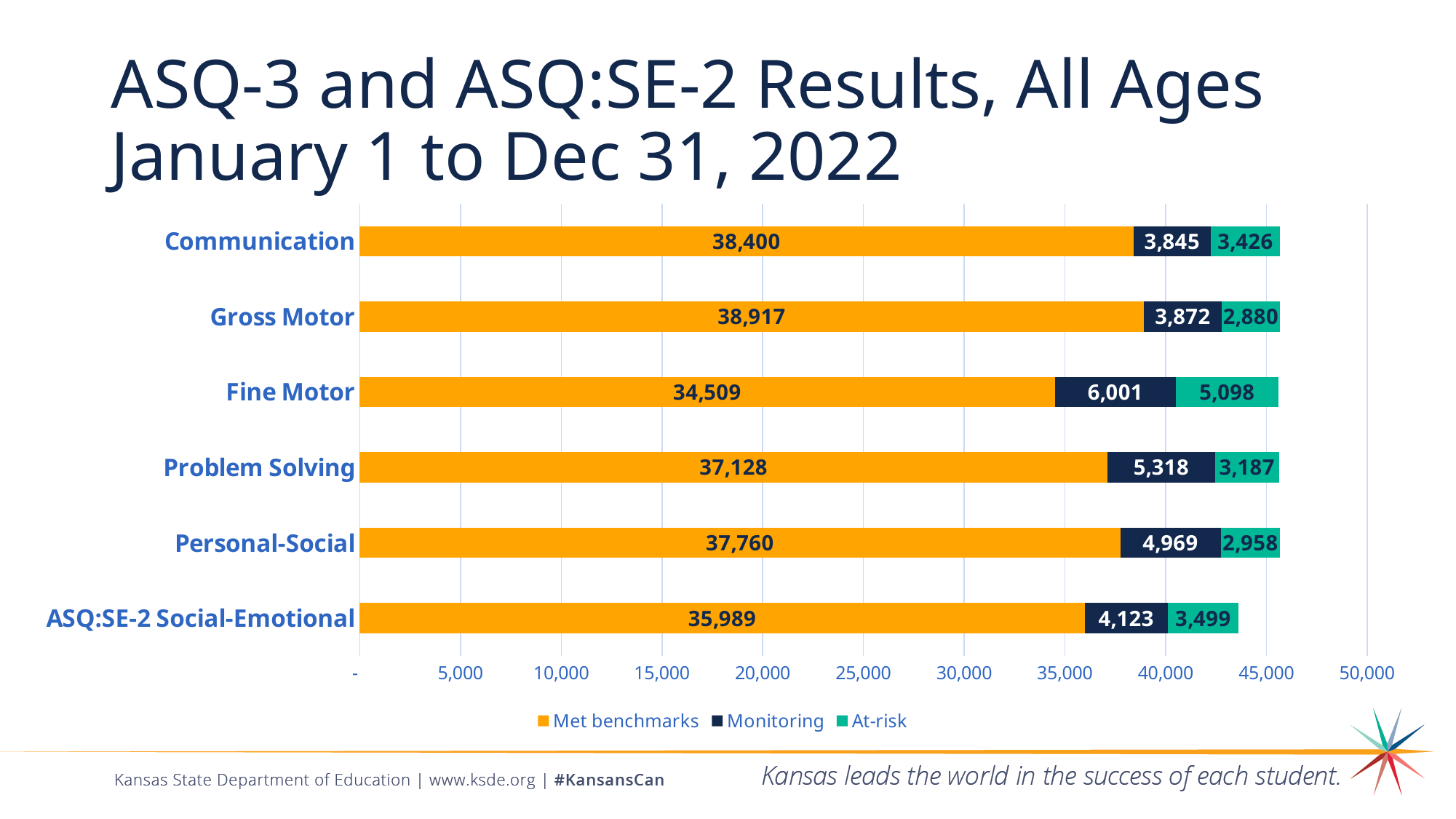
What is the At-risk value for ASQ:SE-2 Social-Emotional? 3,499 Which category has the highest Met benchmarks value? Gross Motor How many categories are shown on the chart? 6 What kind of chart is shown on the slide? Stacked bar chart What is the Monitoring value for Fine Motor? 6,001 What is the difference between the Monitoring values for Fine Motor and Problem Solving? 683 What is the Met benchmarks value for Communication? 38,400 Which category has the lowest Met benchmarks value? Fine Motor Which is larger, the At-risk value for Communication or for Personal-Social? Communication What is the total of the stacked bar for ASQ:SE-2 Social-Emotional? 43,611 How many series does the legend list? 3 Which category has the highest At-risk value? Fine Motor